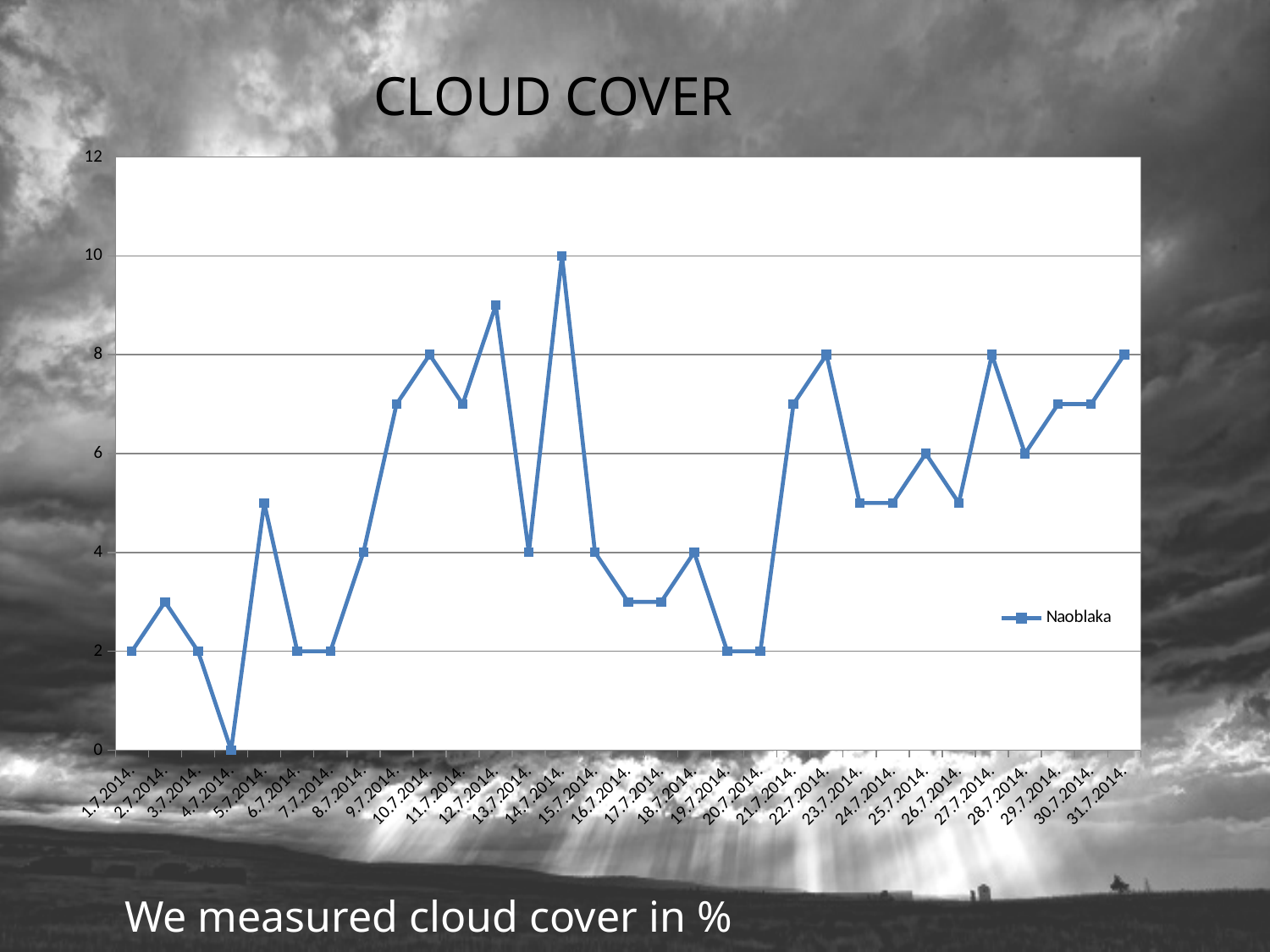
How many series does the legend list? 1 Is the value for 12.7.2014. greater or less than 8? greater What kind of chart is shown on the slide? line chart What is the value for 4.7.2014.? 0 Which is larger, the value for 14.7.2014. or the value for 22.7.2014.? 14.7.2014. How many dates are plotted along the x axis? 31 What is the name of the series listed in the legend? Naoblaka On which date is the cloud cover value lowest? 4.7.2014. On which date is the cloud cover value highest? 14.7.2014. What is the difference between the values for 14.7.2014. and 4.7.2014.? 10 What is the value for 14.7.2014.? 10 What is the title of the chart? CLOUD COVER